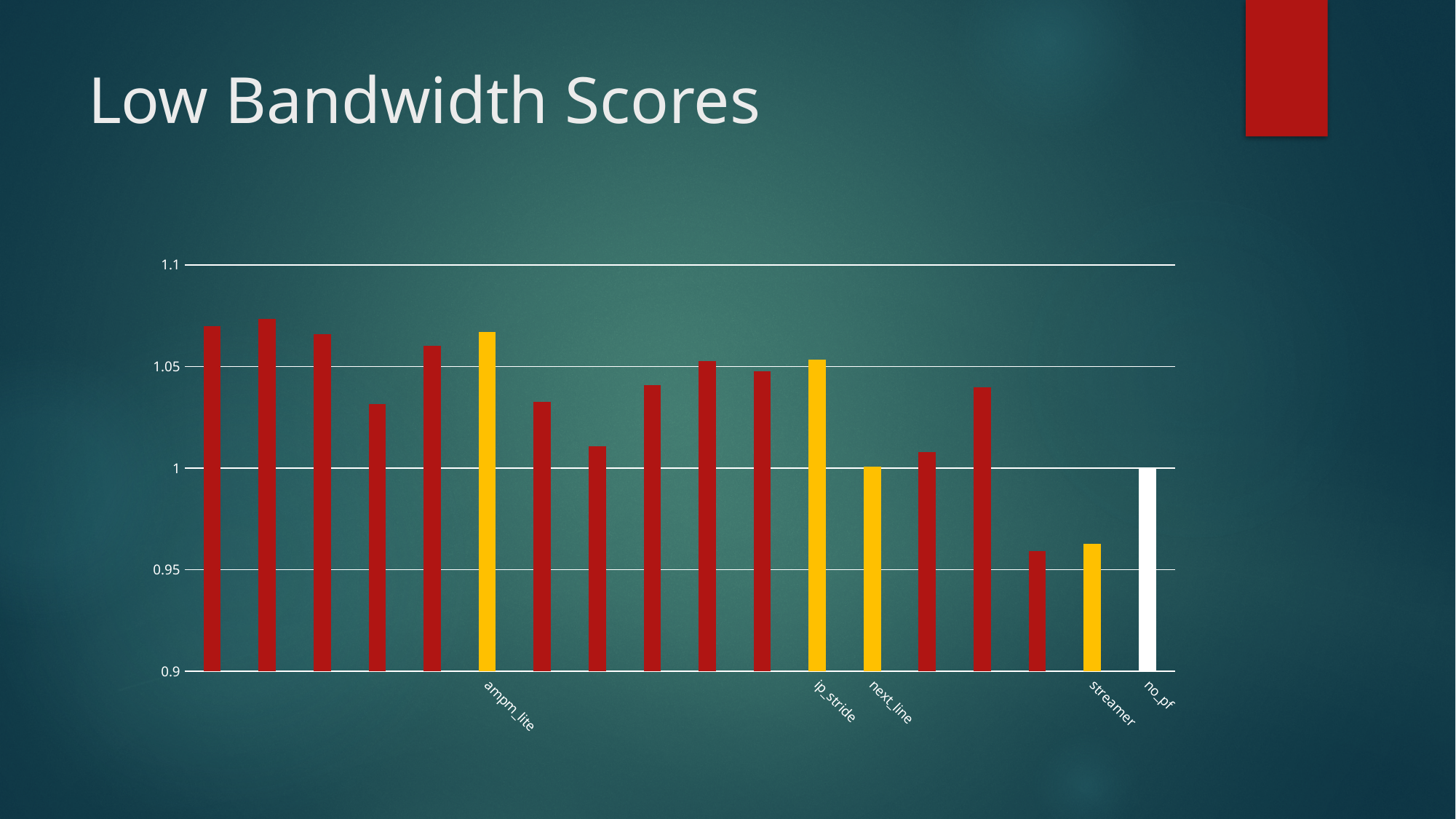
How many bars are plotted in the chart? 18 Which is larger, the value for ampm_lite or the value for ip_stride? ampm_lite Is the value for ampm_lite greater or less than 1.05? greater What colour is the bar for no_pf? white Is the value for streamer greater or less than 0.95? greater Which is larger, the value for next_line or the value for streamer? next_line Is the value for streamer greater or less than 1? less What kind of chart is shown on the slide? bar chart What is the title of the slide containing the chart? Low Bandwidth Scores Among the labelled bars (ampm_lite, ip_stride, next_line, streamer, no_pf), which has the highest value? ampm_lite What is the value for no_pf? 1